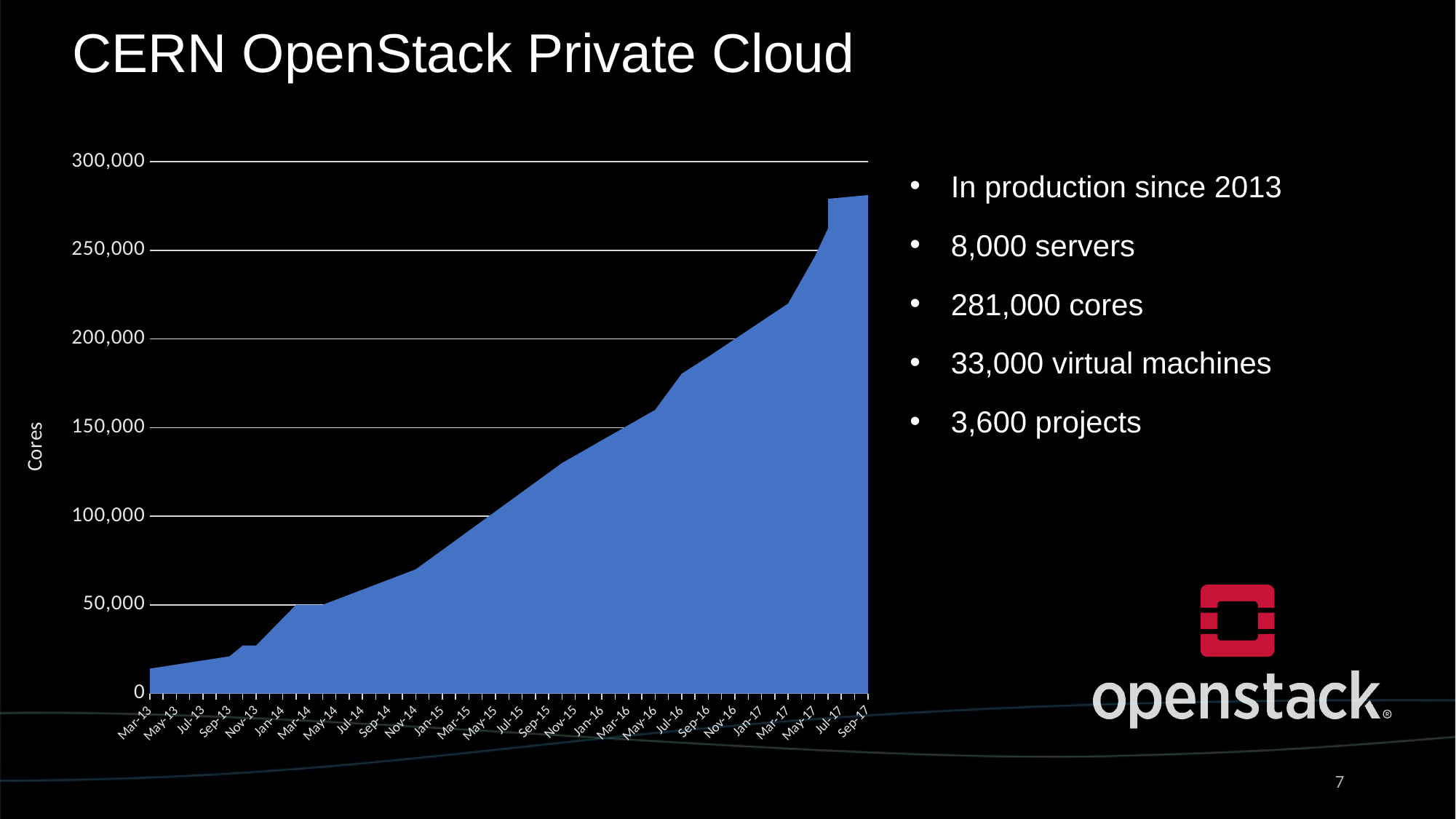
Do the values in the chart rise or fall from Mar-13 to Sep-17? rise Is the value for Sep-15 greater or less than 150,000? less Which date on the x axis has the highest value in the chart? Sep-17 Is the value for Jan-15 greater or less than 100,000? less What is the label on the vertical axis of the chart? Cores What kind of chart is shown on the slide? area chart Is the value for Sep-17 greater or less than 250,000? greater What is the highest tick value shown on the vertical axis? 300,000 Which date on the x axis has the lowest value in the chart? Mar-13 Which has the larger value, Sep-15 or Sep-16? Sep-16